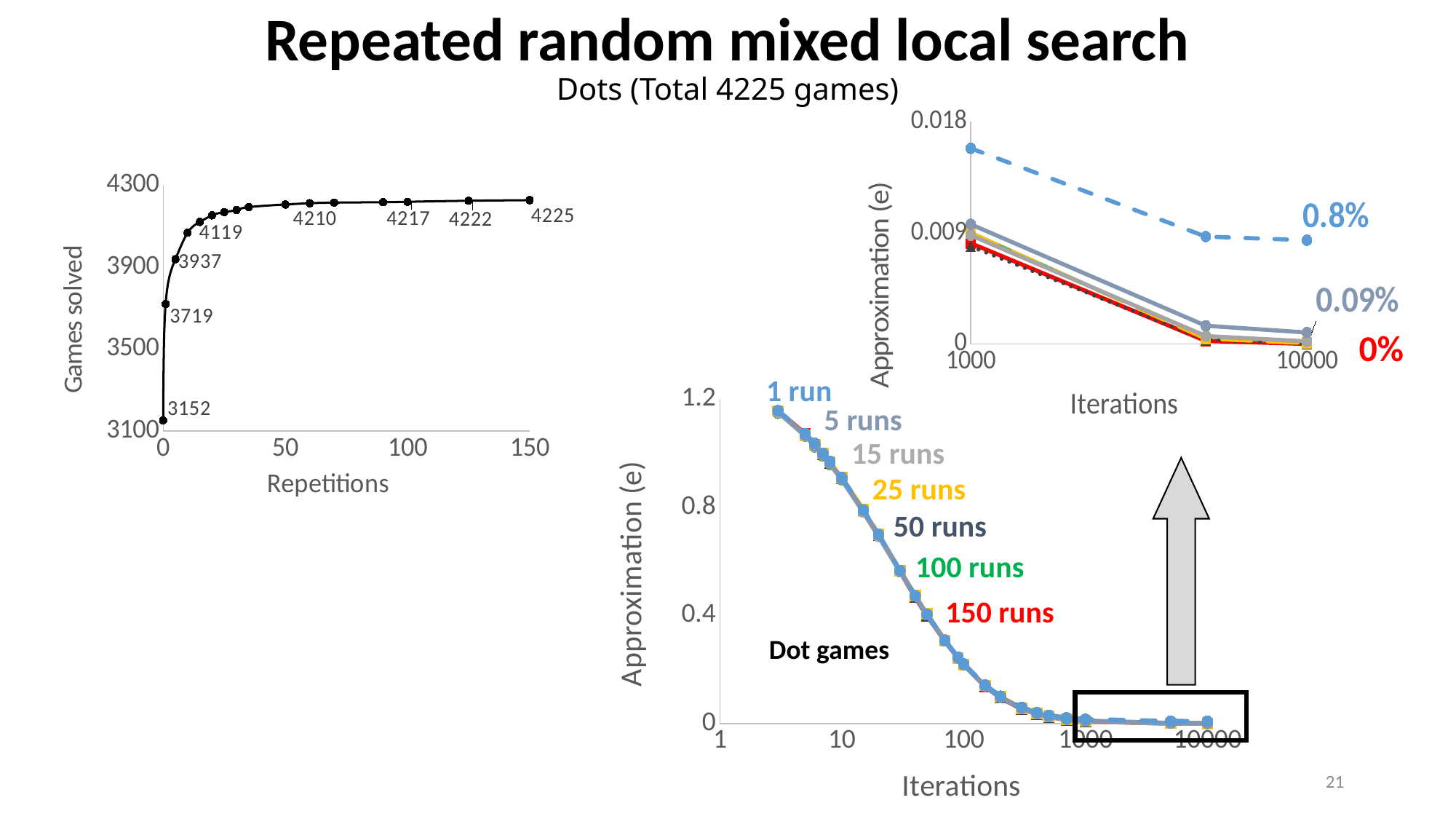
In the left chart (Games solved vs Repetitions), how many data labels are printed on the line? 8 In the top-right inset chart (Approximation (e) vs Iterations from 1000 to 10000), what percentage label is printed next to the red line? 0% In the left chart (Games solved vs Repetitions), do the values rise or fall as repetitions increase? rise In the top-right inset chart (Approximation (e) vs Iterations from 1000 to 10000), which series has the highest value at 10000 iterations? 1 run In the bottom-right chart (Approximation (e) vs Iterations, Dot games), how many series are labeled? 7 In the left chart (Games solved vs Repetitions), what is the value of the final data point at 150 repetitions? 4225 What kind of chart is the left chart (Games solved vs Repetitions)? line chart In the left chart (Games solved vs Repetitions), what is the lowest labeled value of games solved? 3152 In the bottom-right chart (Approximation (e) vs Iterations, Dot games), do the values rise or fall as iterations increase? fall In the left chart (Games solved vs Repetitions), what is the difference between the highest labeled value (4225) and the lowest labeled value (3152)? 1073 In the bottom-right chart (Approximation (e) vs Iterations, Dot games), is the value at 10 iterations greater or less than 0.8? greater In the left chart (Games solved vs Repetitions), is the value at 50 repetitions greater or less than 3900? greater